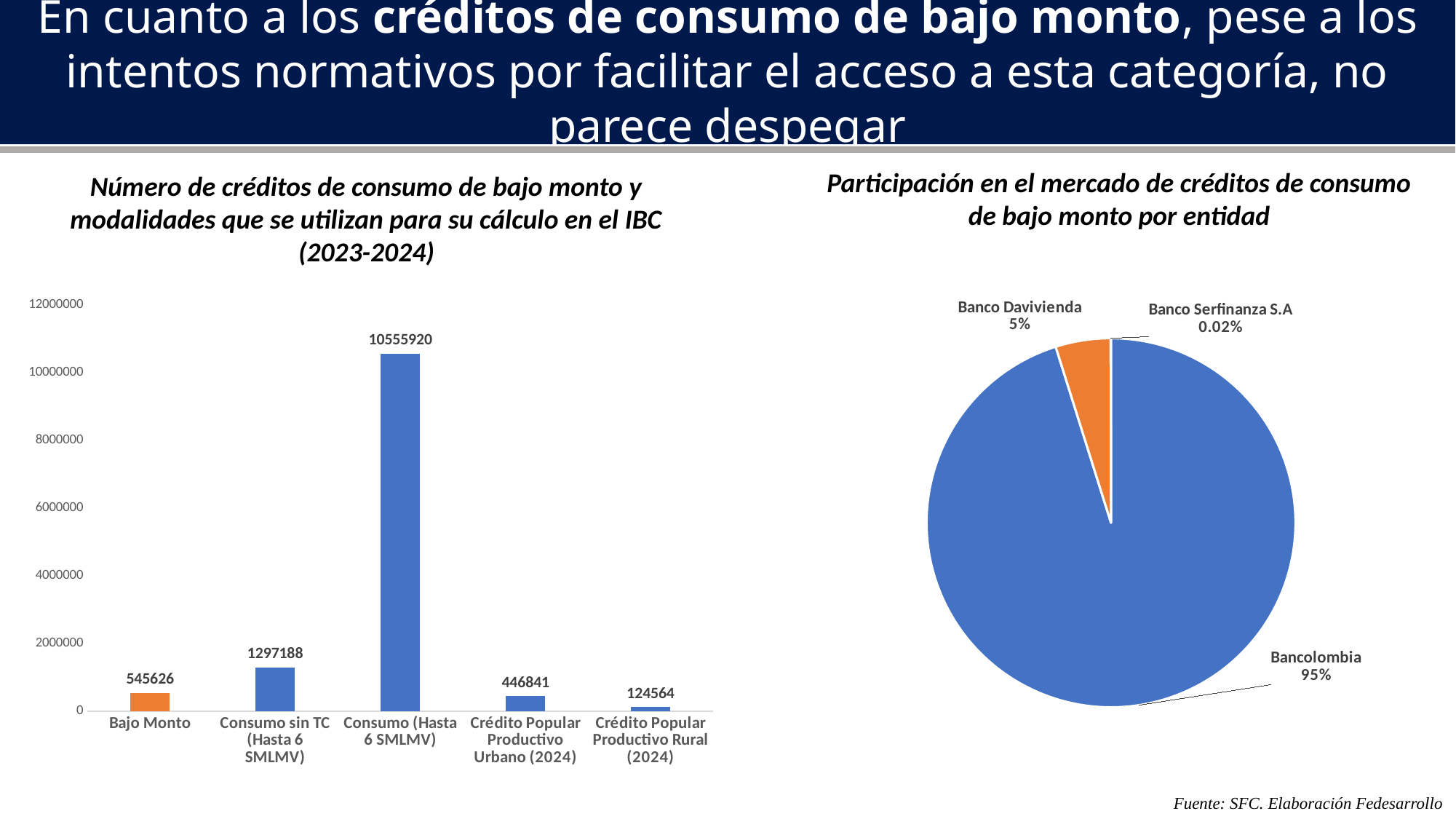
In the pie chart on the right, what share does Banco Serfinanza S.A have? 0.02% In the bar chart on the left, which category has the lowest value? Crédito Popular Productivo Rural (2024) In the pie chart on the right, how many entities are shown? 3 In the bar chart on the left, what is the value for Consumo (Hasta 6 SMLMV)? 10555920 In the bar chart on the left, what is the value for Bajo Monto? 545626 In the bar chart on the left, which category has the highest value? Consumo (Hasta 6 SMLMV) What kind of chart is the chart on the left? Bar chart In the bar chart on the left, how many categories are shown? 5 In the bar chart on the left, what is the difference between Consumo sin TC (Hasta 6 SMLMV) and Bajo Monto? 751562 In the bar chart on the left, which is larger: Bajo Monto or Crédito Popular Productivo Urbano (2024)? Bajo Monto In the pie chart on the right, what share does Bancolombia have? 95% In the bar chart on the left, what is the value for Crédito Popular Productivo Rural (2024)? 124564